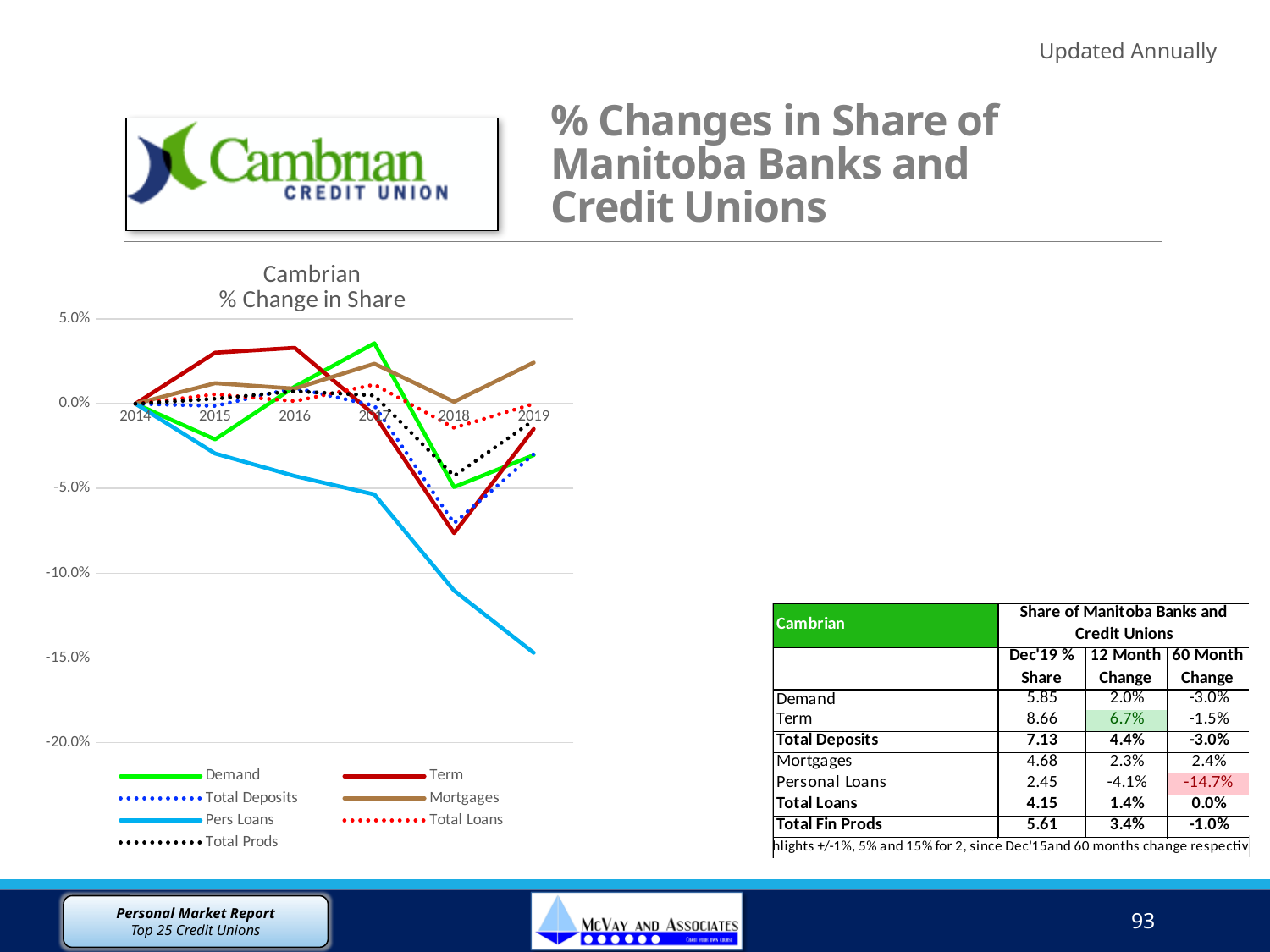
In the "Cambrian % Change in Share" chart, does the Pers Loans line rise or fall from 2014 to 2019? fall How many years are shown on the x axis of the "Cambrian % Change in Share" chart? 6 What kind of chart is the "Cambrian % Change in Share" chart? line chart How many series does the legend of the "Cambrian % Change in Share" chart list? 7 In the "Cambrian % Change in Share" chart, which series has the highest value in 2019? Mortgages In the "Cambrian % Change in Share" chart, is the value for Pers Loans in 2019 greater or less than -10.0%? less In the "Cambrian % Change in Share" chart, which is higher in 2018, Mortgages or Pers Loans? Mortgages In the "Cambrian % Change in Share" chart, is the value for Term in 2018 greater or less than -5.0%? less In the "Cambrian % Change in Share" chart, which series is drawn as a solid green line? Demand In the "Cambrian % Change in Share" chart, which series has the lowest value in 2019? Pers Loans In the "Cambrian % Change in Share" chart, is the value for Demand in 2017 greater or less than 0.0%? greater